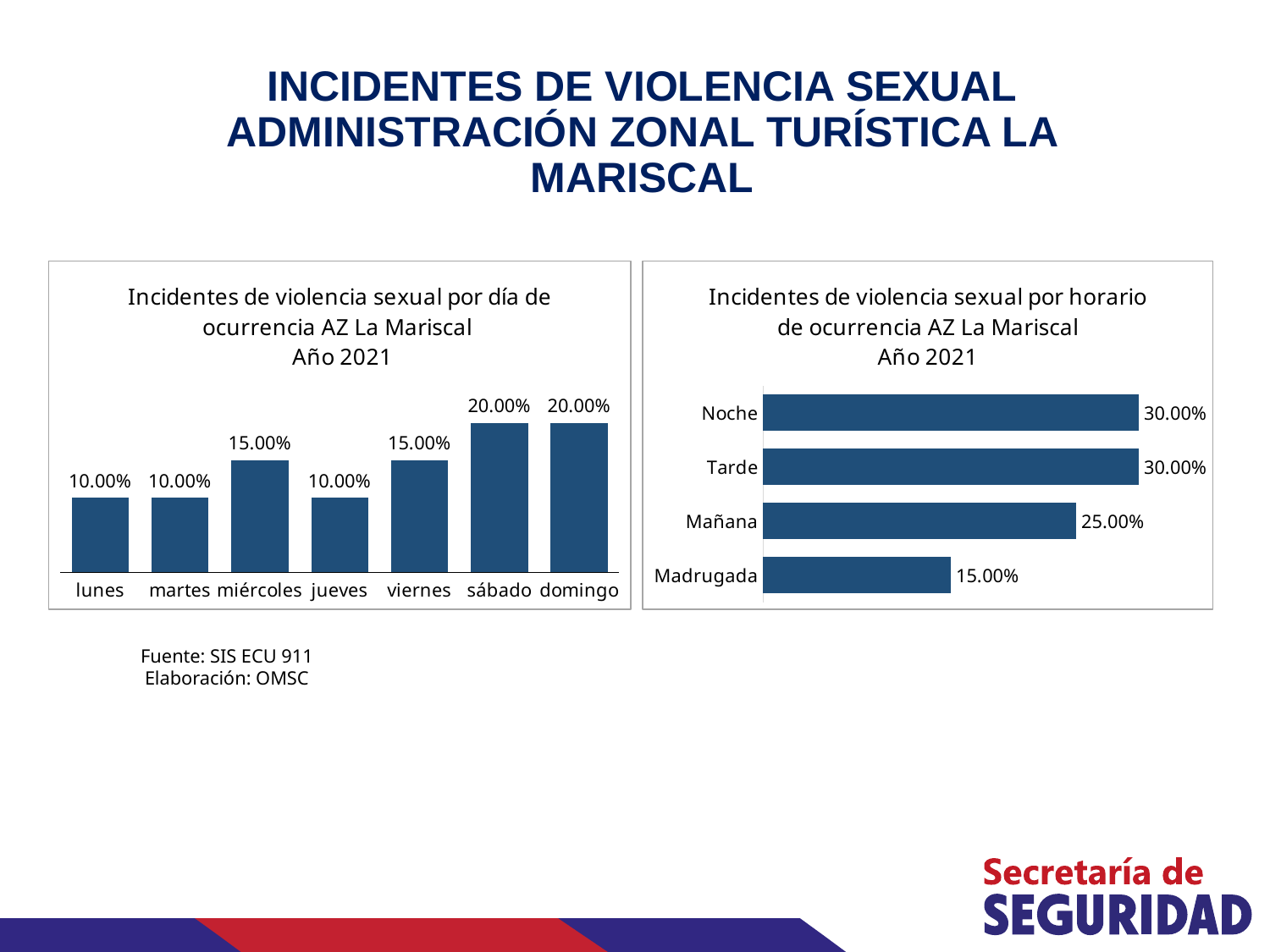
In the left chart (Incidentes de violencia sexual por día de ocurrencia), what is the value for miércoles? 15.00% In the left chart (Incidentes de violencia sexual por día de ocurrencia), which is larger, the value for viernes or the value for martes? viernes In the right chart (Incidentes de violencia sexual por horario de ocurrencia), how many categories are shown? 4 In the right chart (Incidentes de violencia sexual por horario de ocurrencia), which is larger, the value for Tarde or the value for Mañana? Tarde In the left chart (Incidentes de violencia sexual por día de ocurrencia), how many day categories are shown? 7 In the left chart (Incidentes de violencia sexual por día de ocurrencia), what is the lowest value shown? 10.00% In the left chart (Incidentes de violencia sexual por día de ocurrencia), what is the value for jueves? 10.00% In the right chart (Incidentes de violencia sexual por horario de ocurrencia), which category has the lowest value? Madrugada In the left chart (Incidentes de violencia sexual por día de ocurrencia), what is the difference between the value for sábado and the value for lunes? 10.00% In the right chart (Incidentes de violencia sexual por horario de ocurrencia), what is the value for Mañana? 25.00% What kind of chart is the right chart (Incidentes de violencia sexual por horario de ocurrencia)? Bar chart In the right chart (Incidentes de violencia sexual por horario de ocurrencia), what is the difference between the value for Noche and the value for Madrugada? 15.00%